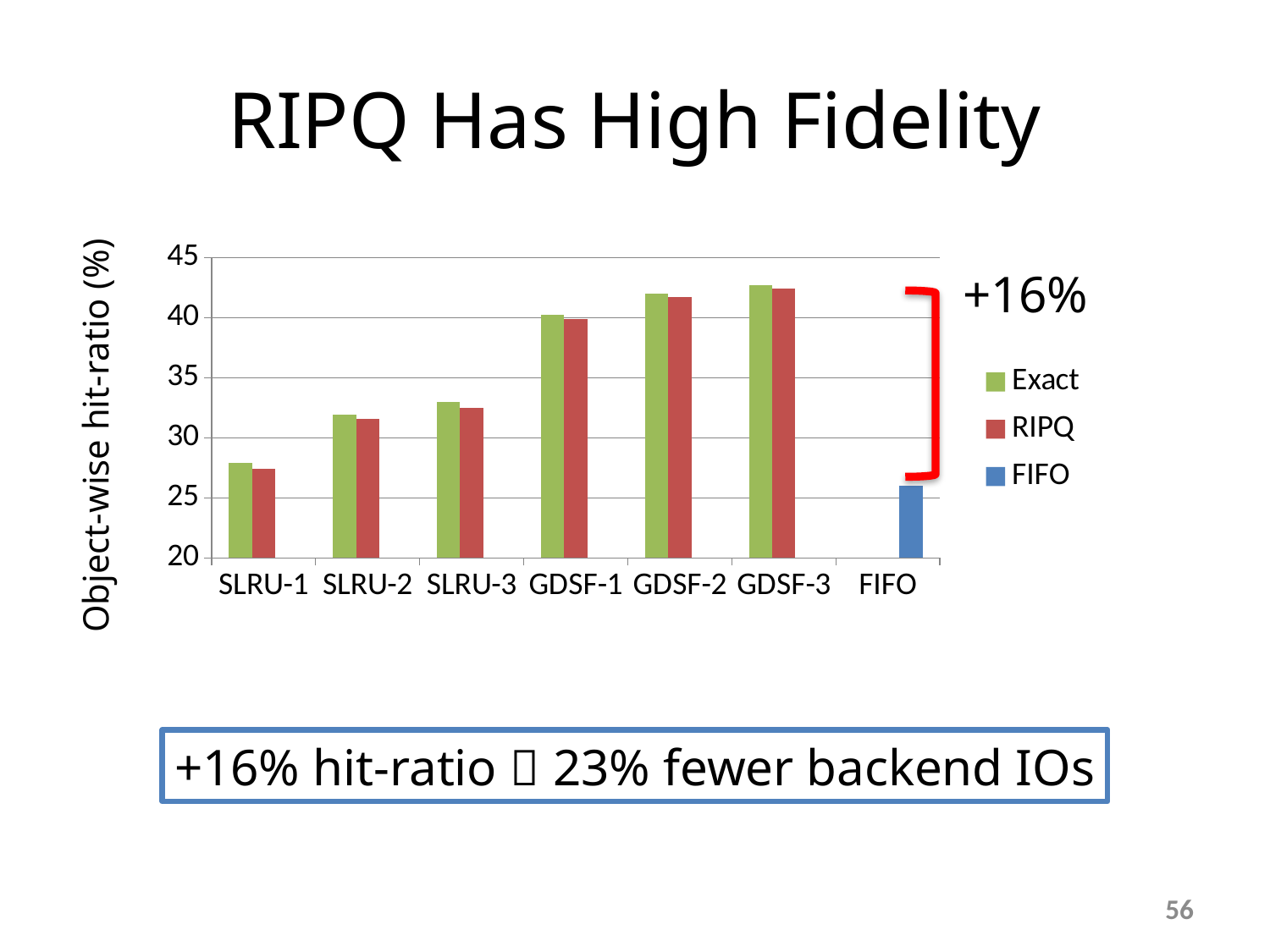
Is the RIPQ value for SLRU-3 greater or less than 35? less Is the FIFO value greater or less than 30? less Is the Exact value for SLRU-1 greater or less than 30? less Which is larger, the Exact value for SLRU-1 or the Exact value for GDSF-1? GDSF-1 Which category has the lowest Exact value? SLRU-1 What is the title of the y axis? Object-wise hit-ratio (%) How many series does the legend list? 3 How many categories are shown on the x axis? 7 What kind of chart is shown on the slide? bar chart Do the Exact values rise or fall from SLRU-1 to GDSF-3? rise